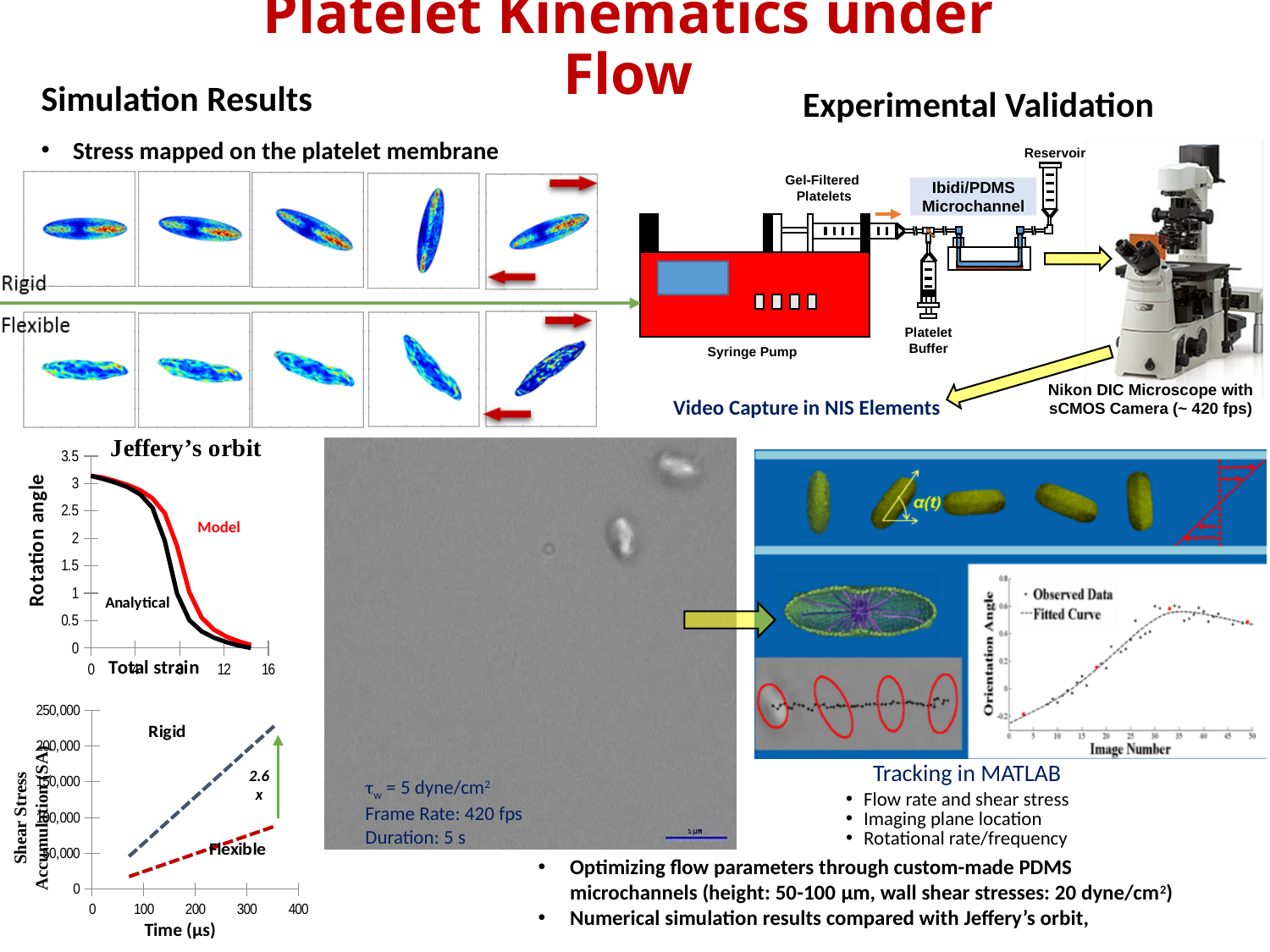
In the Orientation Angle vs Image Number chart on the right, how many series does the legend list? 2 In the Shear Stress Accumulation vs Time chart, which series reaches the higher value, Rigid or Flexible? Rigid In the "Jeffery's orbit" chart, which series has the higher rotation angle at a total strain of 8, Model or Analytical? Model In the Shear Stress Accumulation vs Time chart, is the Rigid value at 300 µs greater or less than 150,000? greater What kind of chart is the "Jeffery's orbit" chart? line chart In the Shear Stress Accumulation vs Time chart, how many series are plotted? 2 In the Shear Stress Accumulation vs Time chart, is the Flexible value at 300 µs greater or less than 100,000? less In the "Jeffery's orbit" chart, does the rotation angle rise or fall as total strain increases? fall In the "Jeffery's orbit" chart, what is the highest value shown on the x axis? 16 In the "Jeffery's orbit" chart, is the rotation angle at a total strain of 12 greater or less than 0.5? less In the Shear Stress Accumulation vs Time chart, do the values rise or fall as time increases? rise In the "Jeffery's orbit" chart, how many series are plotted? 2